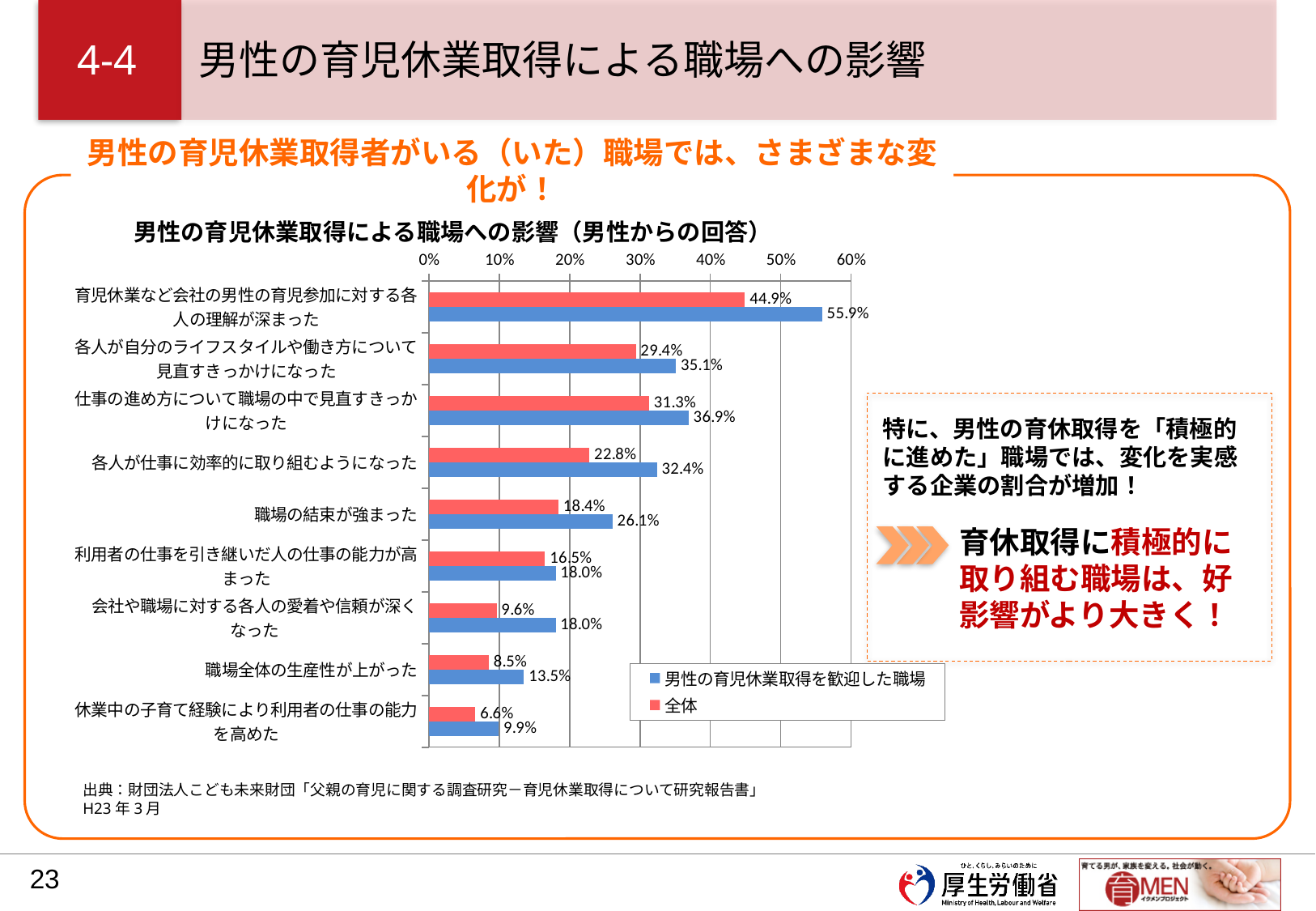
What type of chart is shown on the slide? Bar chart In the category 「職場の結束が強まった」, which series has the larger value, 「男性の育児休業取得を歓迎した職場」 or 「全体」? 男性の育児休業取得を歓迎した職場 What is the value for 「全体」 in the category 「職場全体の生産性が上がった」? 8.5% Is the value for 「全体」 in the category 「仕事の進め方について職場の中で見直すきっかけになった」 greater or less than 30%? greater How many series does the legend list? 2 How many categories are plotted in the chart? 9 Which category has the highest value for 「男性の育児休業取得を歓迎した職場」? 育児休業など会社の男性の育児参加に対する各人の理解が深まった What is the title of the chart? 男性の育児休業取得による職場への影響（男性からの回答） What is the difference between 「男性の育児休業取得を歓迎した職場」 and 「全体」 in the category 「会社や職場に対する各人の愛着や信頼が深くなった」? 8.4% Which category has the lowest value for 「全体」? 休業中の子育て経験により利用者の仕事の能力を高めた What is the value for 「全体」 in the category 「育児休業など会社の男性の育児参加に対する各人の理解が深まった」? 44.9% What is the value for 「男性の育児休業取得を歓迎した職場」 in the category 「各人が仕事に効率的に取り組むようになった」? 32.4%